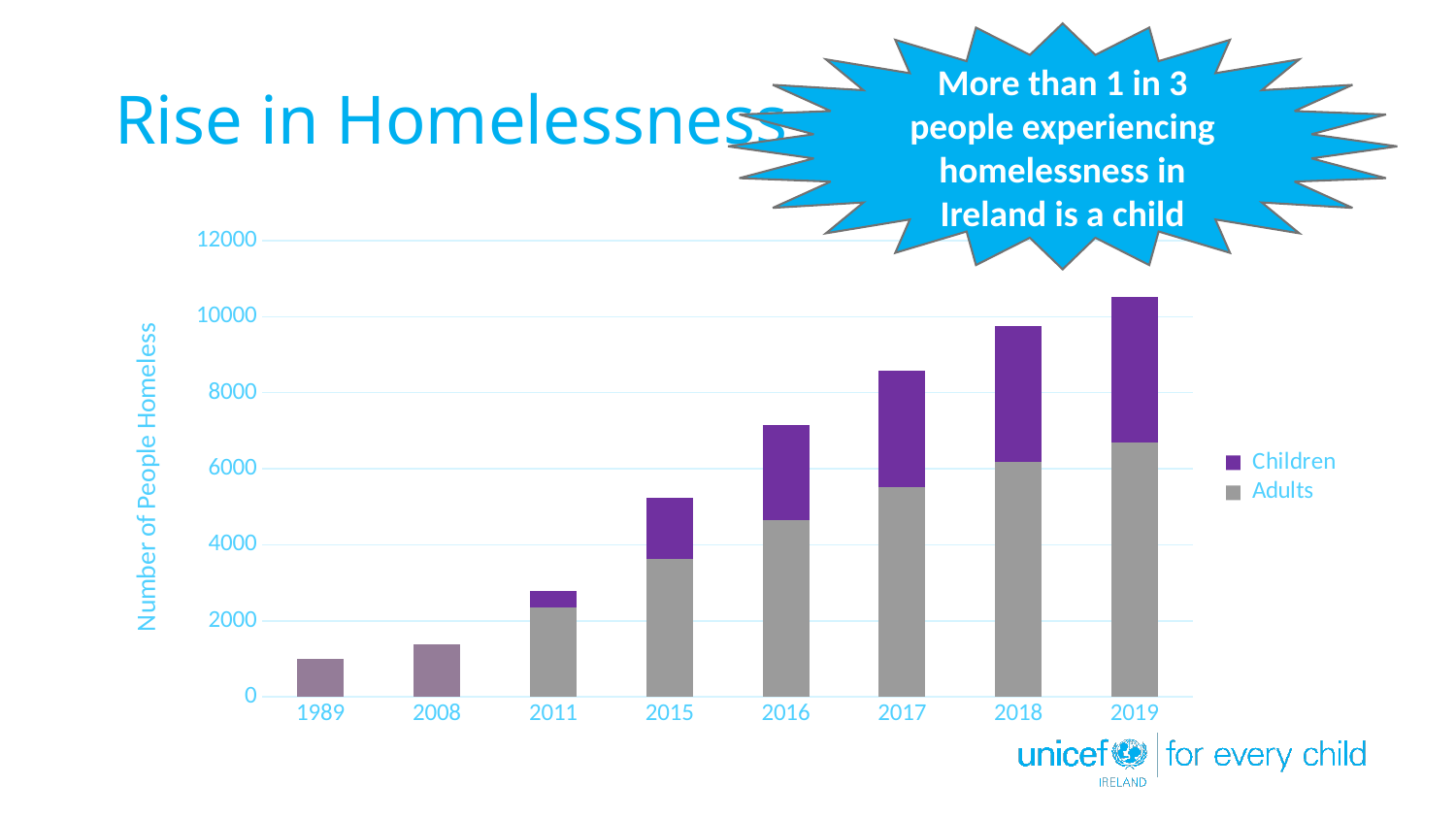
How many years are shown on the x axis of the chart? 8 Is the Adults value for 2017 greater or less than 6000? less Is the total value for 2008 greater or less than 2000? less Which year has the highest total number of people homeless? 2019 Which year has a larger total, 2015 or 2017? 2017 What kind of chart is shown on the slide? bar chart Which year has the lowest total number of people homeless? 1989 Is the total value for 2019 greater or less than 10000? greater How many series does the chart legend list? 2 Do the total values rise or fall from 1989 to 2019? rise What is the title of the y axis? Number of People Homeless